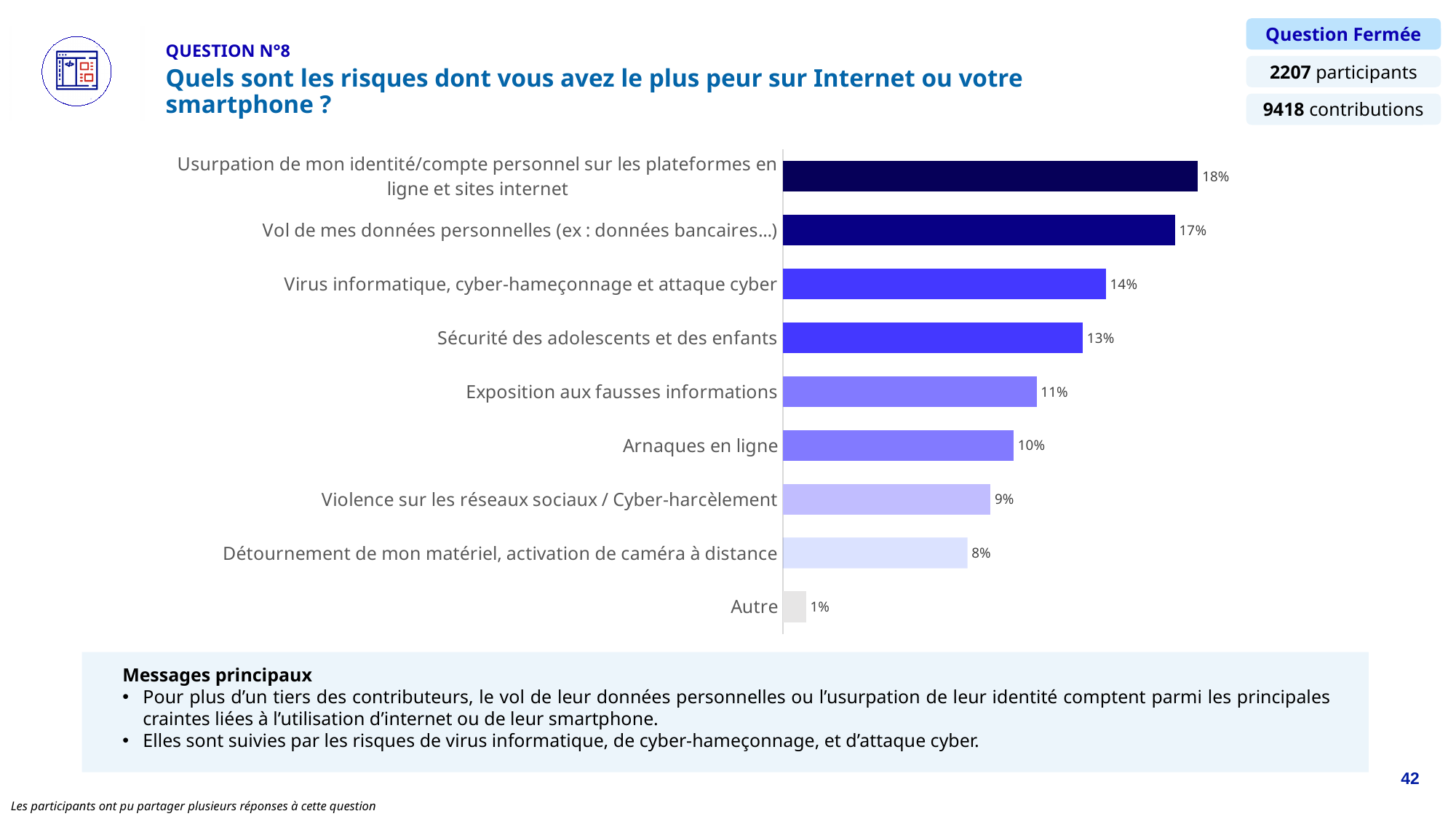
What is the value for "Vol de mes données personnelles (ex : données bancaires…)"? 17% Which is larger: the value for "Violence sur les réseaux sociaux / Cyber-harcèlement" or the value for "Arnaques en ligne"? Arnaques en ligne Which category has the lowest value? Autre What kind of chart is shown on the slide? Bar chart What is the difference between the values for "Usurpation de mon identité/compte personnel sur les plateformes en ligne et sites internet" and "Autre"? 17% What is the value for "Détournement de mon matériel, activation de caméra à distance"? 8% What is the difference between the values for "Virus informatique, cyber-hameçonnage et attaque cyber" and "Exposition aux fausses informations"? 3% How many categories are shown in the chart? 9 How many participants are indicated on the slide? 2207 What is the value for "Arnaques en ligne"? 10% Which category has the highest value? Usurpation de mon identité/compte personnel sur les plateformes en ligne et sites internet What is the value for "Sécurité des adolescents et des enfants"? 13%